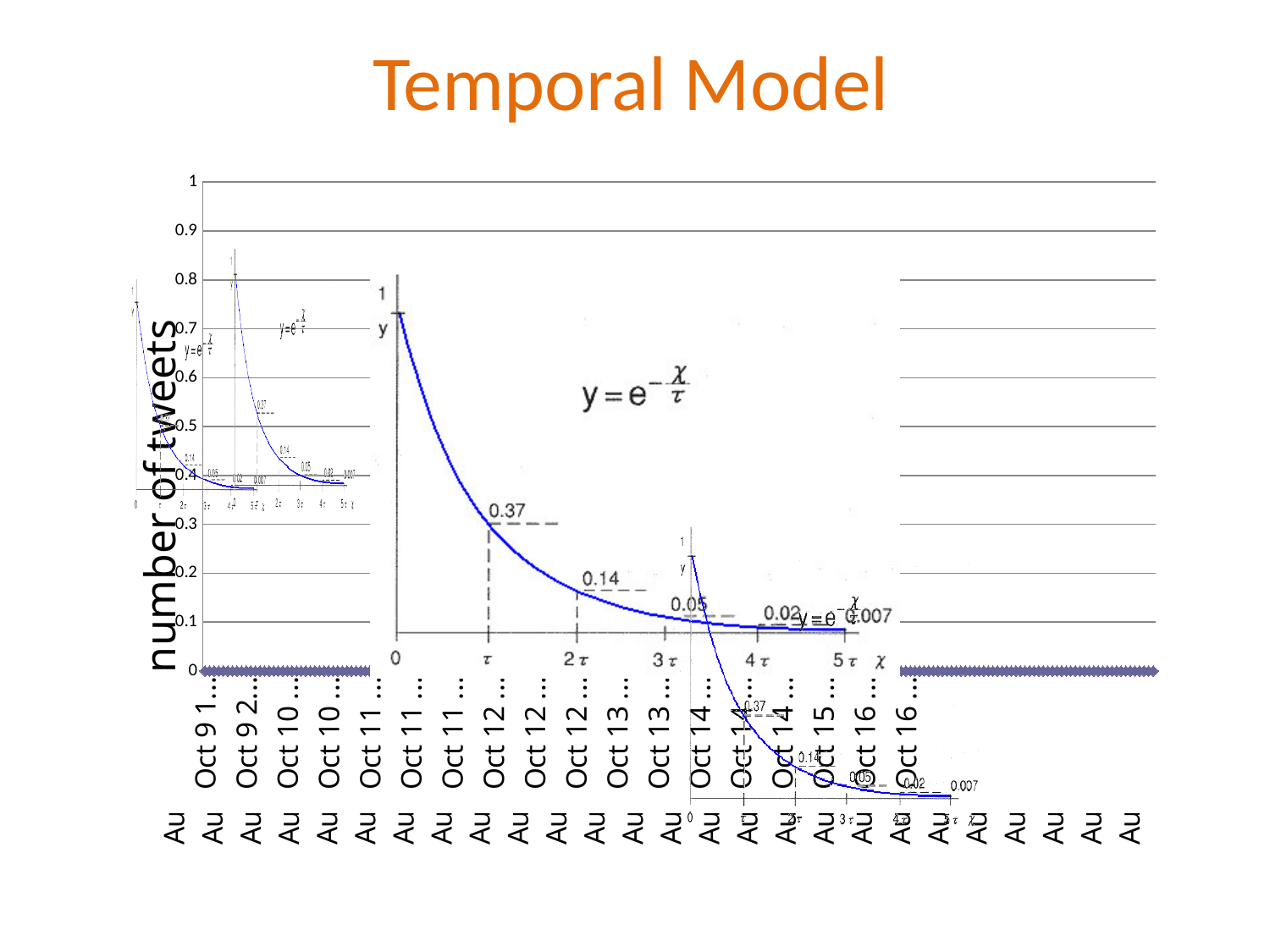
On the large decay curve, what is the value of y at χ = τ? 0.37 On the large decay curve, do the values rise or fall as χ increases? fall On the large decay curve, what is the value of y at χ = 4τ? 0.02 On the large decay curve, what is the value of y at χ = 5τ? 0.007 On the large decay curve, what is the difference between the value at τ and the value at 2τ? 0.23 What equation is written on the large decay curve overlaid on the chart? y = e^(-χ/τ) On the large decay curve, which is larger: the value at τ or the value at 3τ? the value at τ On the large decay curve, which labelled point has the lowest value? 5τ On the large decay curve, what is the value of y at χ = 2τ? 0.14 What is the label on the vertical axis of the chart? number of tweets On the large decay curve, which labelled point has the highest value? τ On the large decay curve, what is the value of y at χ = 3τ? 0.05